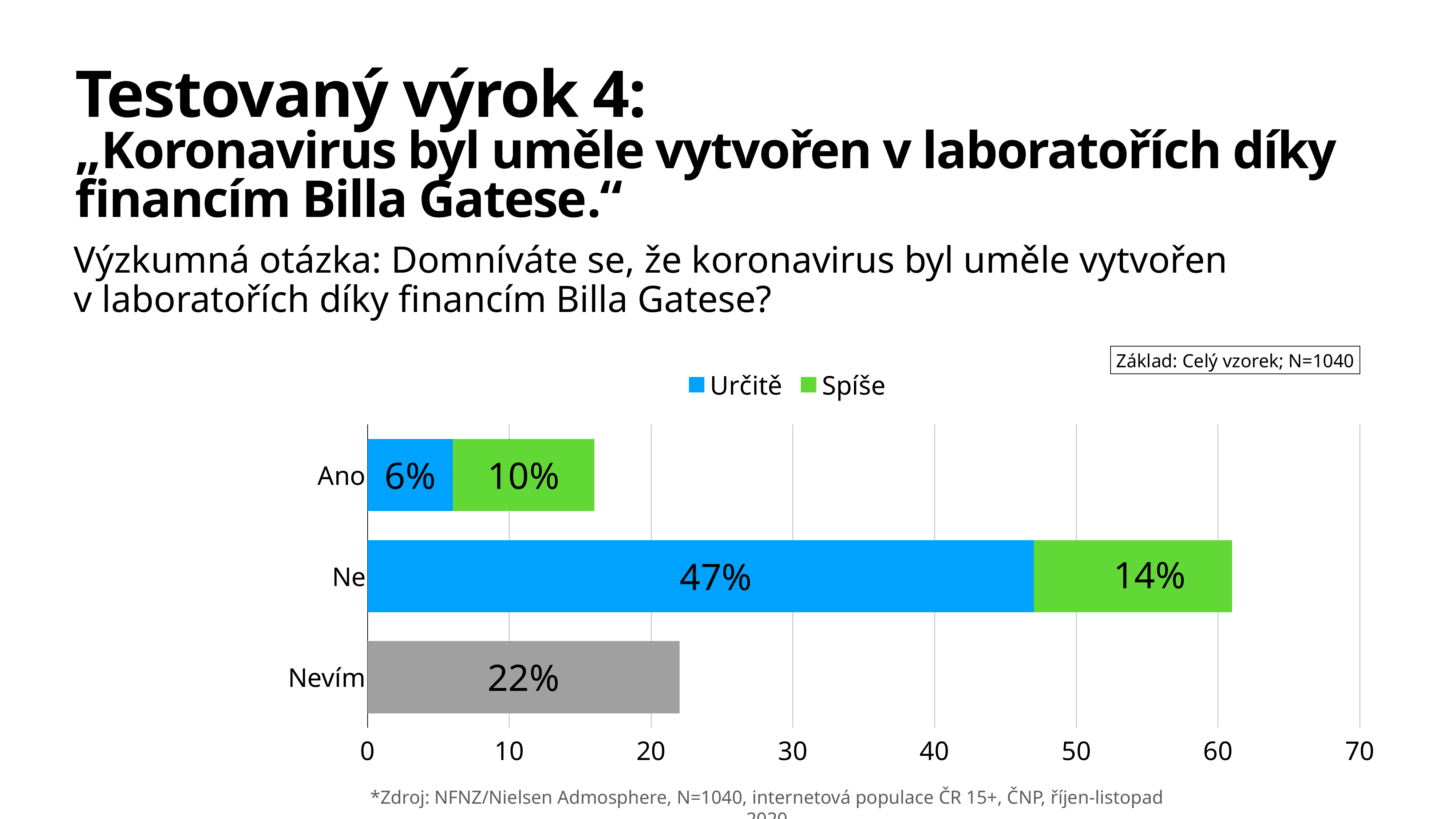
What is the total of the stacked bar for the 'Ano' category? 16% What is the 'Určitě' value for the 'Ne' category? 47% How many categories are shown on the vertical axis? 3 Which category has the longest bar overall? Ne What is the 'Určitě' value for the 'Ano' category? 6% What is the total of the stacked bar for the 'Ne' category? 61% What is the difference between the 'Určitě' values for 'Ne' and 'Ano'? 41% What is the 'Spíše' value for the 'Ne' category? 14% How many series does the legend list? 2 What is the 'Spíše' value for the 'Ano' category? 10% Which is larger: the 'Spíše' value for 'Ano' or the 'Spíše' value for 'Ne'? Ne What is the value shown for the 'Nevím' category? 22%